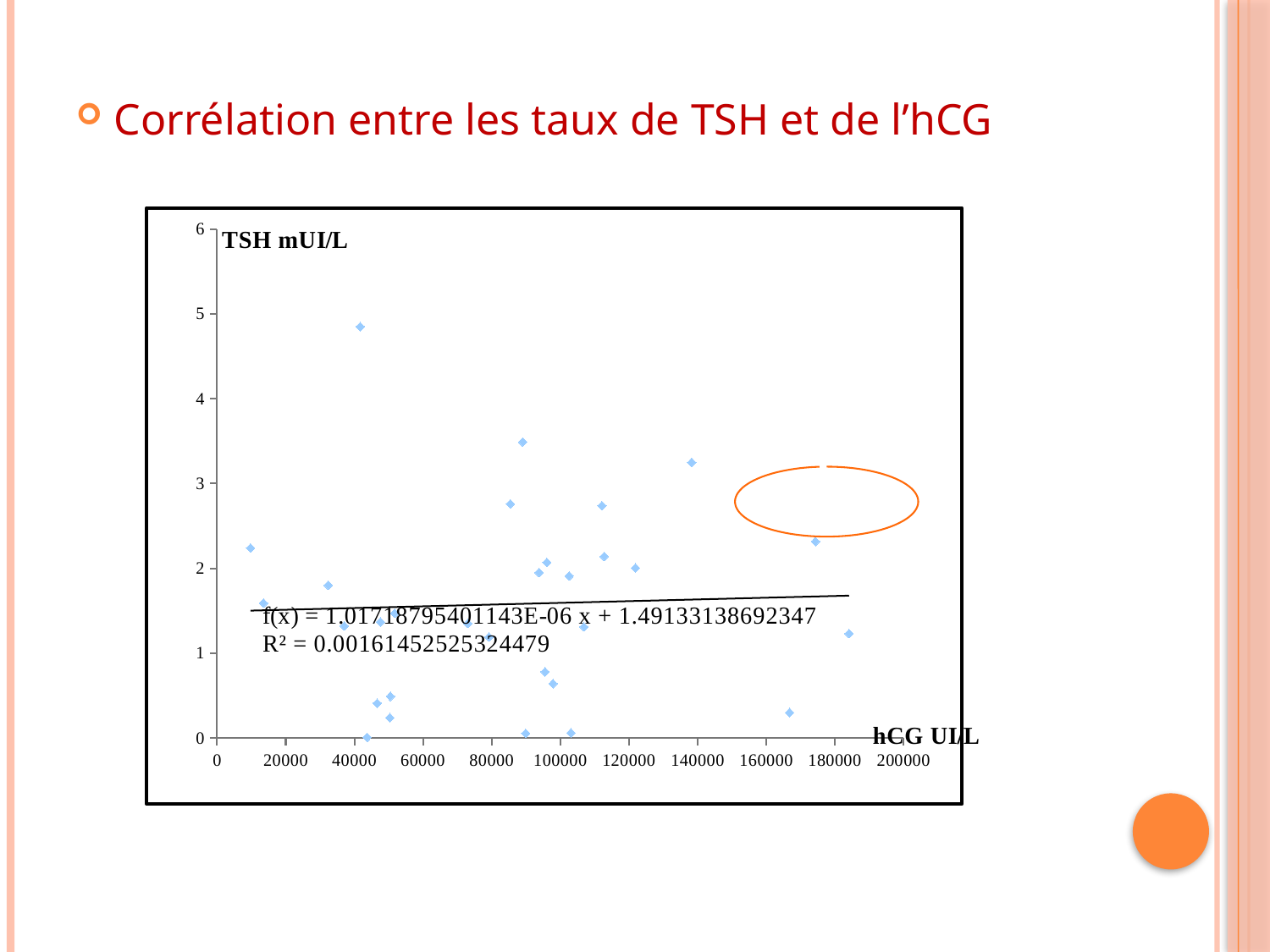
What is the intercept (constant term) of the fitted line equation printed on the chart? 1.49133138692347 What is the label of the vertical axis of the chart? TSH mUI/L Is the TSH value of the point plotted near hCG 175000 greater or less than 2? greater Does the fitted trend line rise or fall as hCG increases? rises What is the label of the horizontal axis of the chart? hCG UI/L Is the TSH value of the point plotted near hCG 167000 greater or less than 1? less What is the maximum value shown on the vertical (TSH) axis? 6 Is the TSH value of the point plotted near hCG 138000 greater or less than 3? greater What is the slope coefficient of the fitted line equation printed on the chart? 1.01718795401143E-06 What kind of chart is shown on the slide? scatter plot What R² value is printed on the chart? 0.00161452525324479